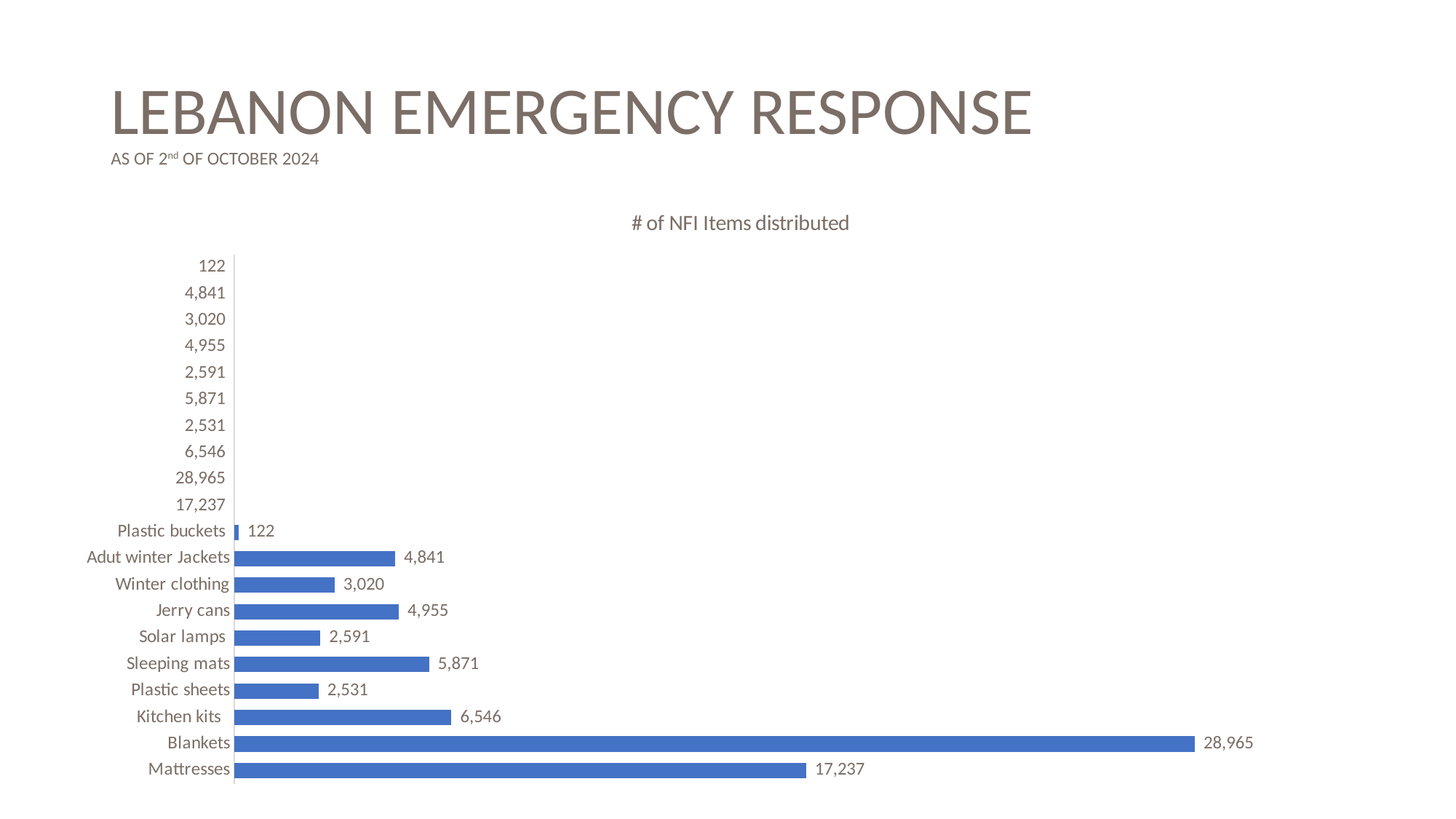
What is the difference between the values for Kitchen kits and Sleeping mats? 675 What type of chart is shown on the slide? bar chart What is the difference between the number of Blankets and the number of Mattresses distributed? 11,728 Which item has the highest number distributed? Blankets What is the value for Plastic buckets? 122 Which item has the lowest number distributed? Plastic buckets What is the title of the chart? # of NFI Items distributed Which is larger, the value for Sleeping mats or the value for Winter clothing? Sleeping mats How many Blankets were distributed? 28,965 How many named item categories have bars plotted in the chart? 10 How many Mattresses were distributed? 17,237 What is the value for Kitchen kits? 6,546